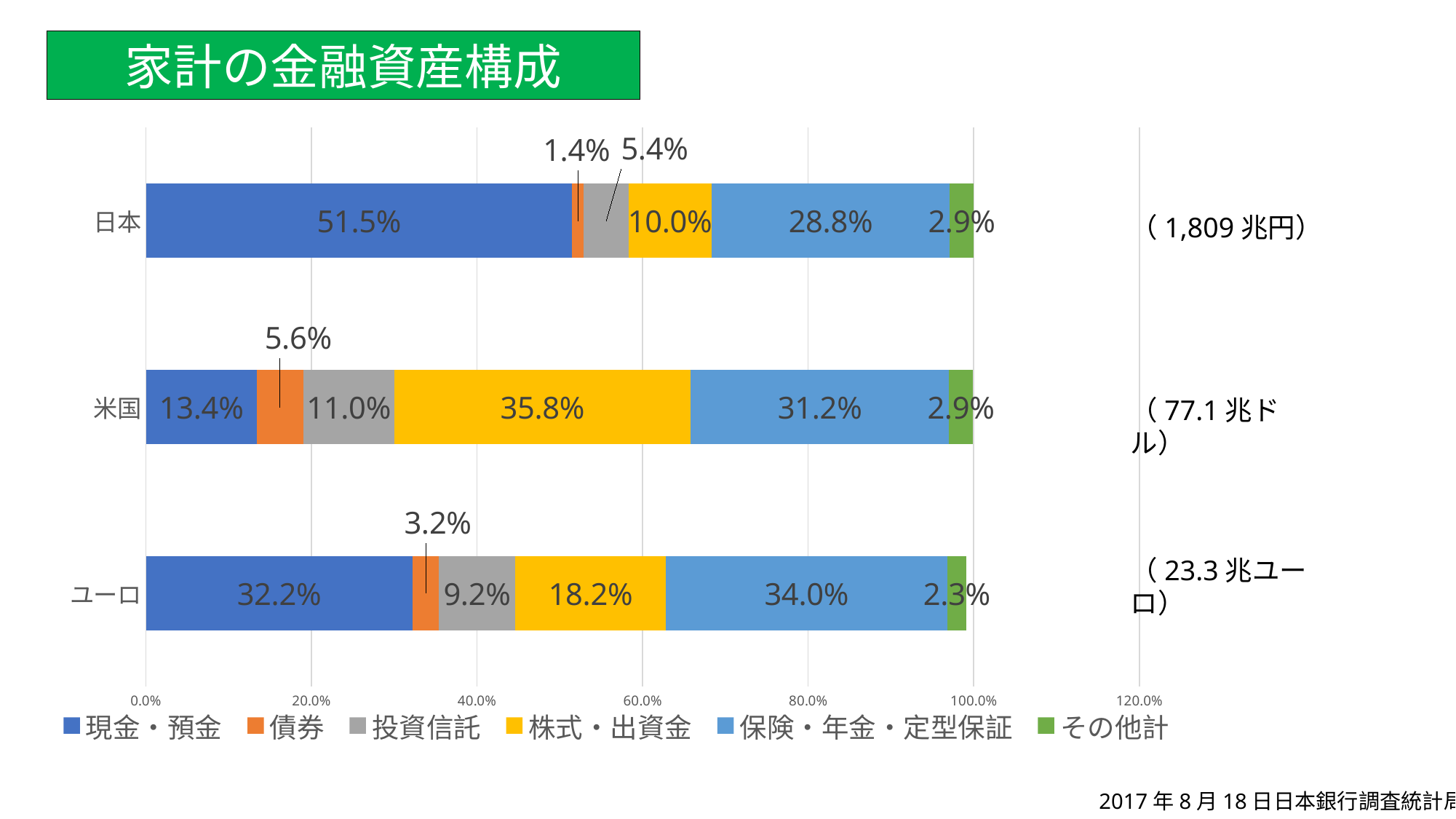
Which is larger: the 投資信託 share for 米国 or for ユーロ? 米国 How many series does the legend list? 6 What is the share of 株式・出資金 for 米国? 35.8% What is the share of 保険・年金・定型保証 for ユーロ? 34.0% What is the share of 現金・預金 for 日本? 51.5% What kind of chart is shown on the slide? stacked bar chart Which region has the lowest share of 株式・出資金? 日本 What is the difference between the 株式・出資金 share for 米国 and for ユーロ? 17.6% How many categories (regions) are plotted on the chart? 3 What is the title of the chart? 家計の金融資産構成 What is the share of 債券 for 日本? 1.4% Which region has the highest share of 現金・預金? 日本